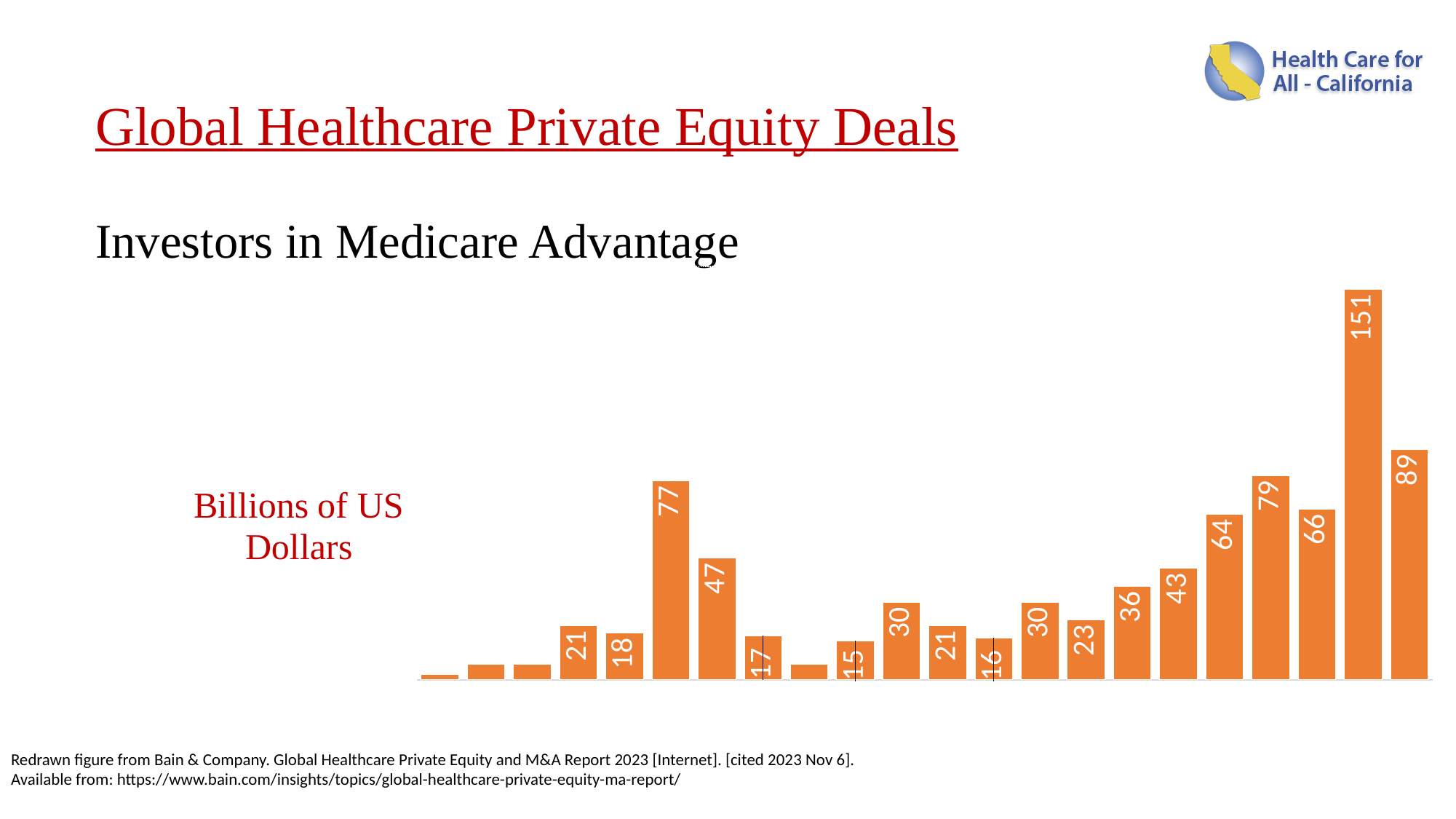
What is the value shown on the tallest bar in the chart? 151 What unit does the chart's axis label say the values are in? Billions of US Dollars Which is larger: the bar labeled 77 or the bar labeled 47? 77 What colour are the bars in the chart? orange What is the value of the second-tallest bar in the chart? 89 How many bars in the chart are labeled 30? 2 How many bars are plotted in the chart? 22 How many bars in the chart have a value above 100? 1 What is the difference between the bar labeled 77 and the bar labeled 47 next to it? 30 What kind of chart is shown on the slide? bar chart What is the difference between the tallest bar (151) and the rightmost bar (89)? 62 What value is labeled on the rightmost bar of the chart? 89